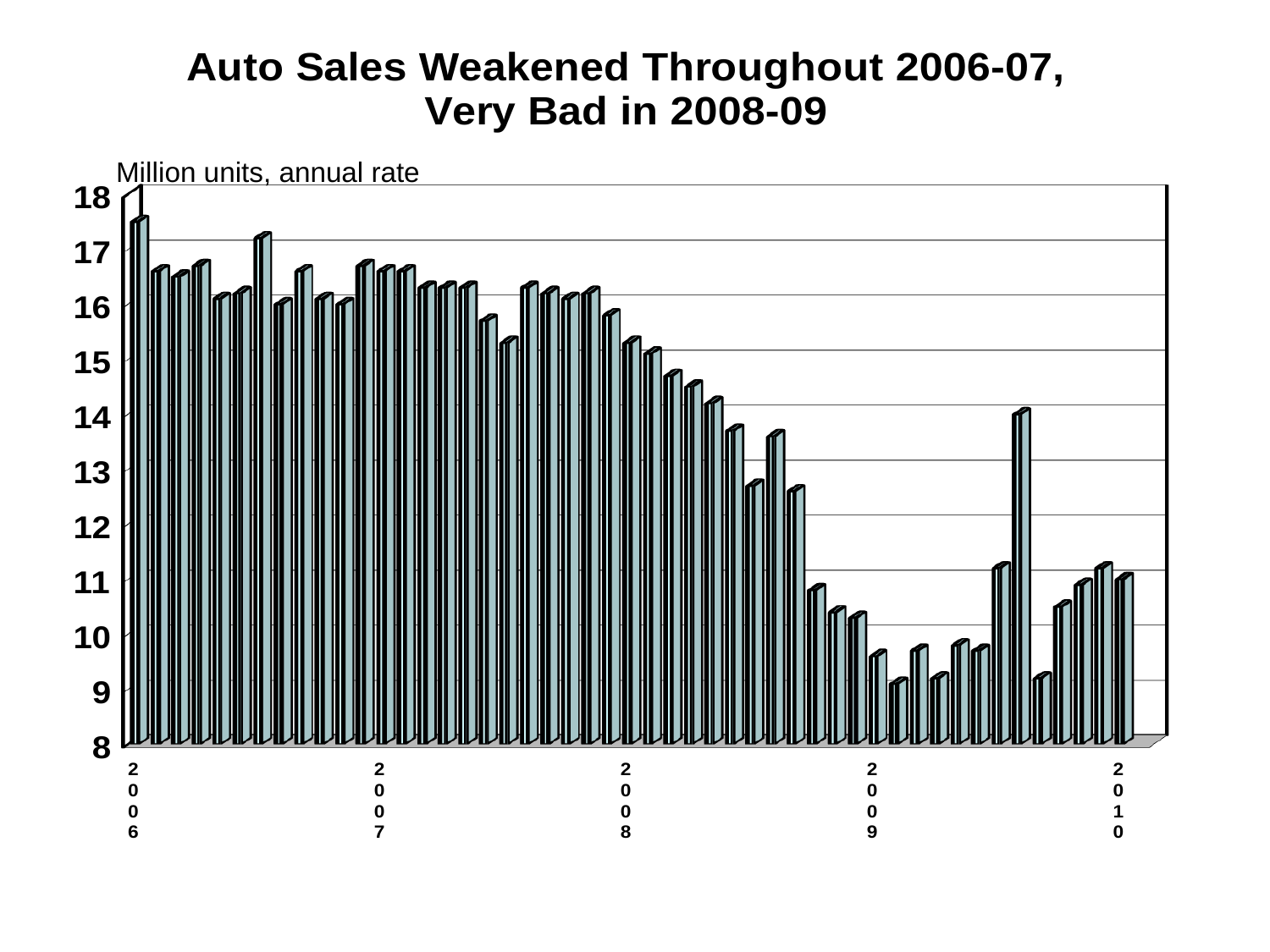
What is the title of the chart? Auto Sales Weakened Throughout 2006-07, Very Bad in 2008-09 Is the value for the first bar of 2008 greater or less than 15? greater Is the value for the first bar of 2006 greater or less than 17? greater Do auto sales generally rise or fall from 2006 through early 2009? fall Is the value for the first bar of 2007 greater or less than 16? greater Which is larger, the first bar of 2007 or the first bar of 2008? the first bar of 2007 Which is larger, the first bar of 2006 or the first bar of 2009? the first bar of 2006 How many year labels appear along the x axis? 5 What kind of chart is shown on the slide? bar chart What unit label is shown above the vertical axis? Million units, annual rate